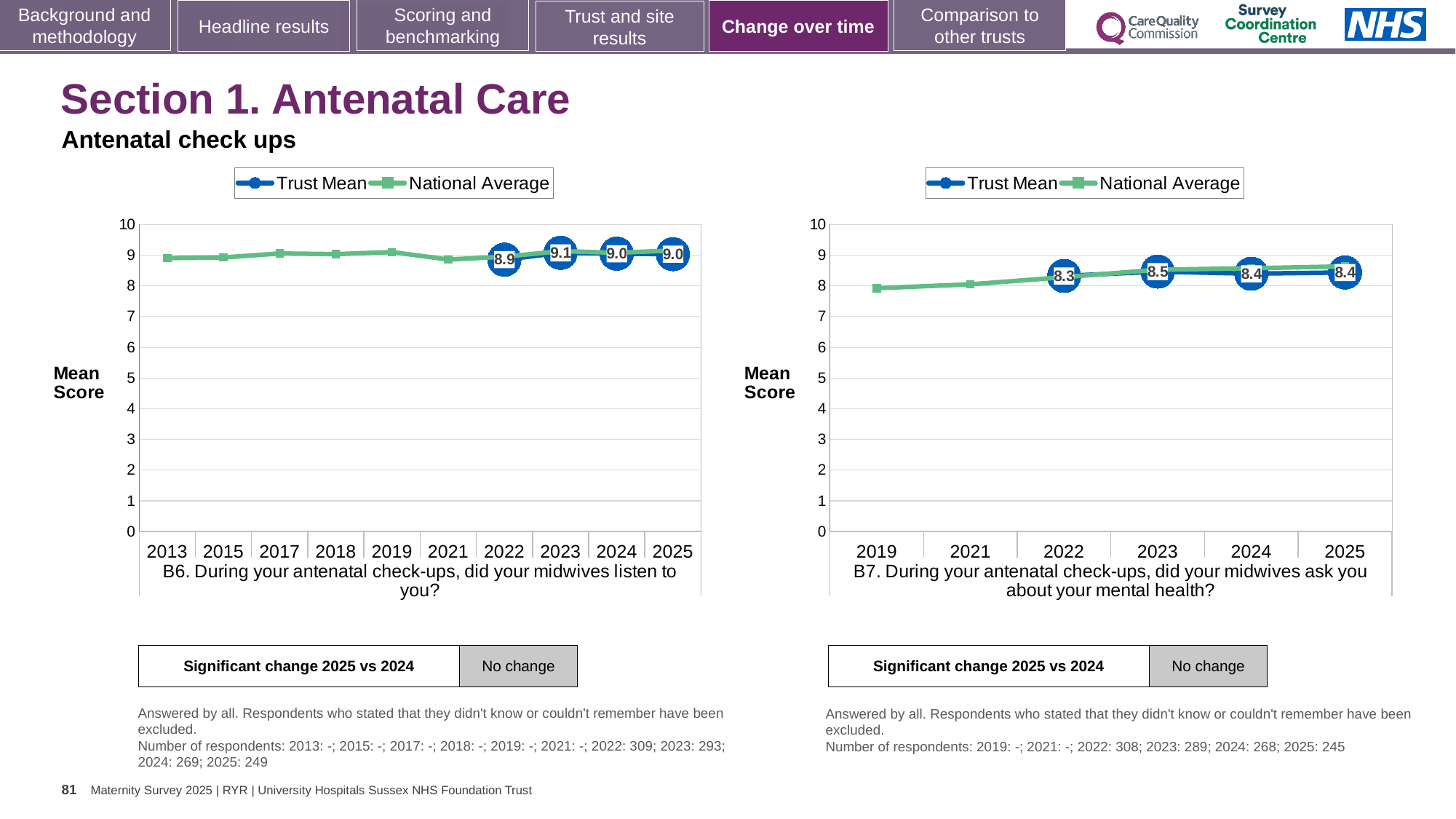
In the B6 chart (left), which year has the highest labelled Trust Mean? 2023 What type of chart is the B6 chart (left)? Line chart In the B6 chart (left), what is the Trust Mean for 2023? 9.1 In the B7 chart (right), what is the Trust Mean for 2025? 8.4 How many series does the legend of the B6 chart (left) list? 2 In the B7 chart (right), which year has the lowest labelled Trust Mean? 2022 In the B7 chart (right), is the Trust Mean higher in 2023 or in 2022? 2023 How many years are shown on the x axis of the B7 chart (right)? 6 In the B6 chart (left), what is the difference between the Trust Mean in 2023 and in 2022? 0.2 In the B7 chart (right), what is the Trust Mean for 2022? 8.3 In the B6 chart (left), is the National Average for 2013 greater or less than 8? greater In the B6 chart (left), what is the Trust Mean for 2022? 8.9